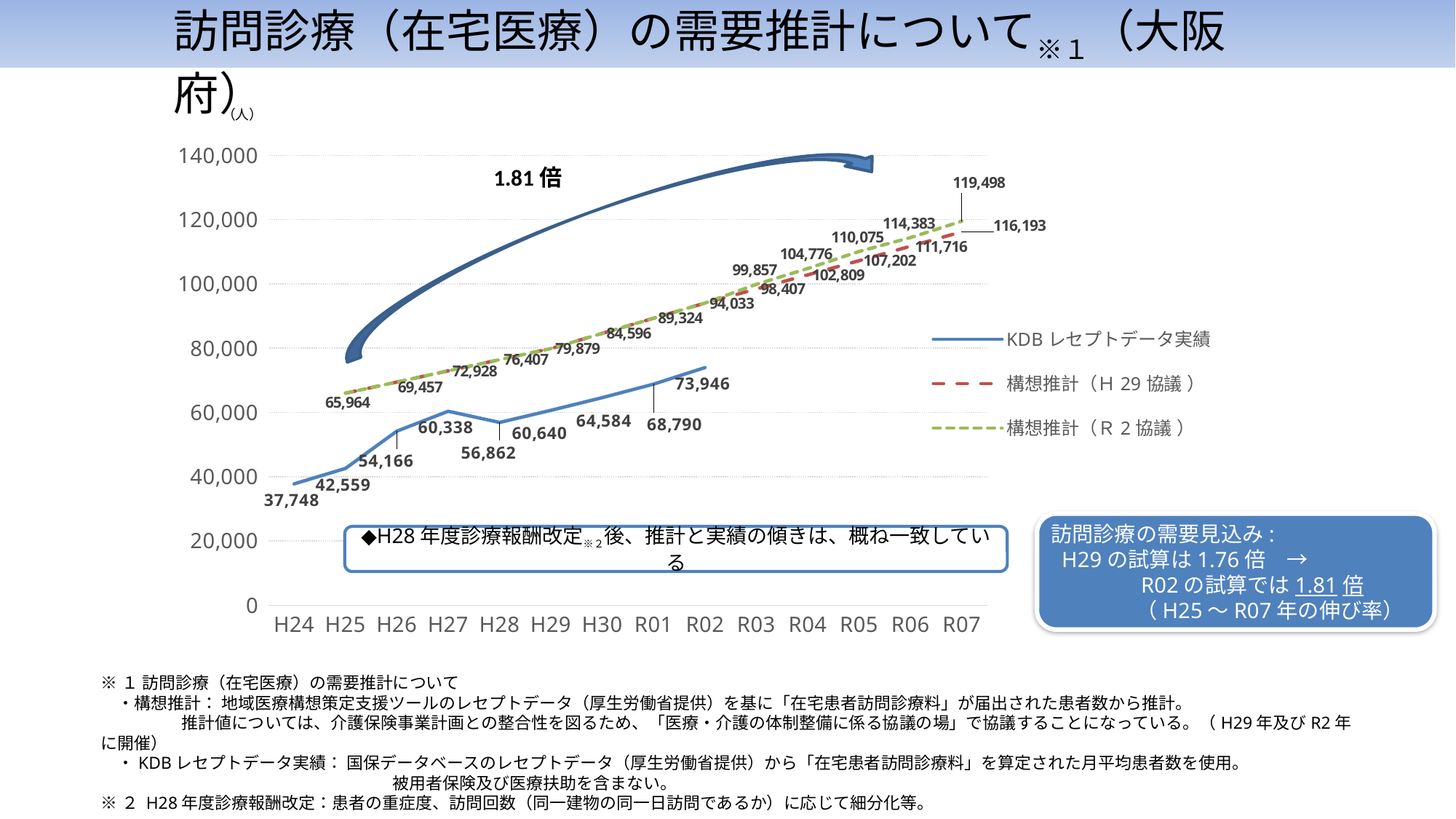
What is the value of KDBレセプトデータ実績 for R02? 73,946 What is the difference between 構想推計（R2協議） and 構想推計（H29協議） for R07? 3,305 What is the value of KDBレセプトデータ実績 for H24? 37,748 How many year categories are shown on the x axis? 14 How many series does the legend list? 3 What is the value of 構想推計（R2協議） for R07? 119,498 What multiplier is written next to the large arrow on the chart? 1.81倍 In which year is KDBレセプトデータ実績 lowest? H24 What kind of chart is shown on the slide? line chart What is the value of 構想推計（H29協議） for R07? 116,193 In which year is KDBレセプトデータ実績 highest? R02 For KDBレセプトデータ実績, which is larger, the value for H27 or the value for H28? H27